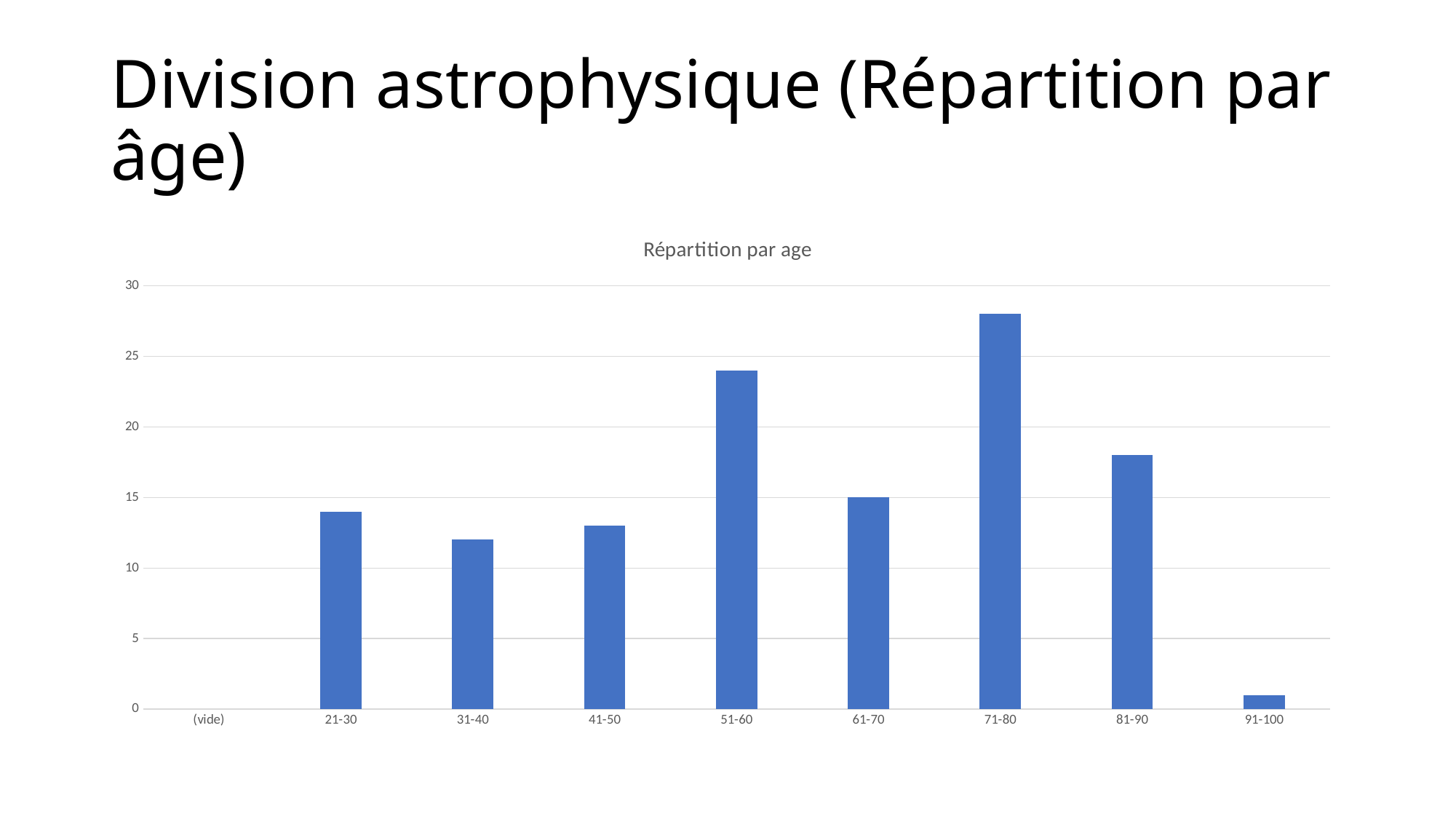
How many categories are shown on the x axis of the chart? 9 Is the value for 91-100 greater or less than 5? less Among the categories with a visible bar, which age category has the lowest value? 91-100 Is the value for 51-60 greater or less than 20? greater Which age category has the highest value? 71-80 Is the value for 31-40 greater or less than 15? less What kind of chart is shown on the slide? bar chart Which has the larger value, 51-60 or 81-90? 51-60 Which has the larger value, 21-30 or 31-40? 21-30 What is the title of the chart? Répartition par age What is the value for the 61-70 category? 15